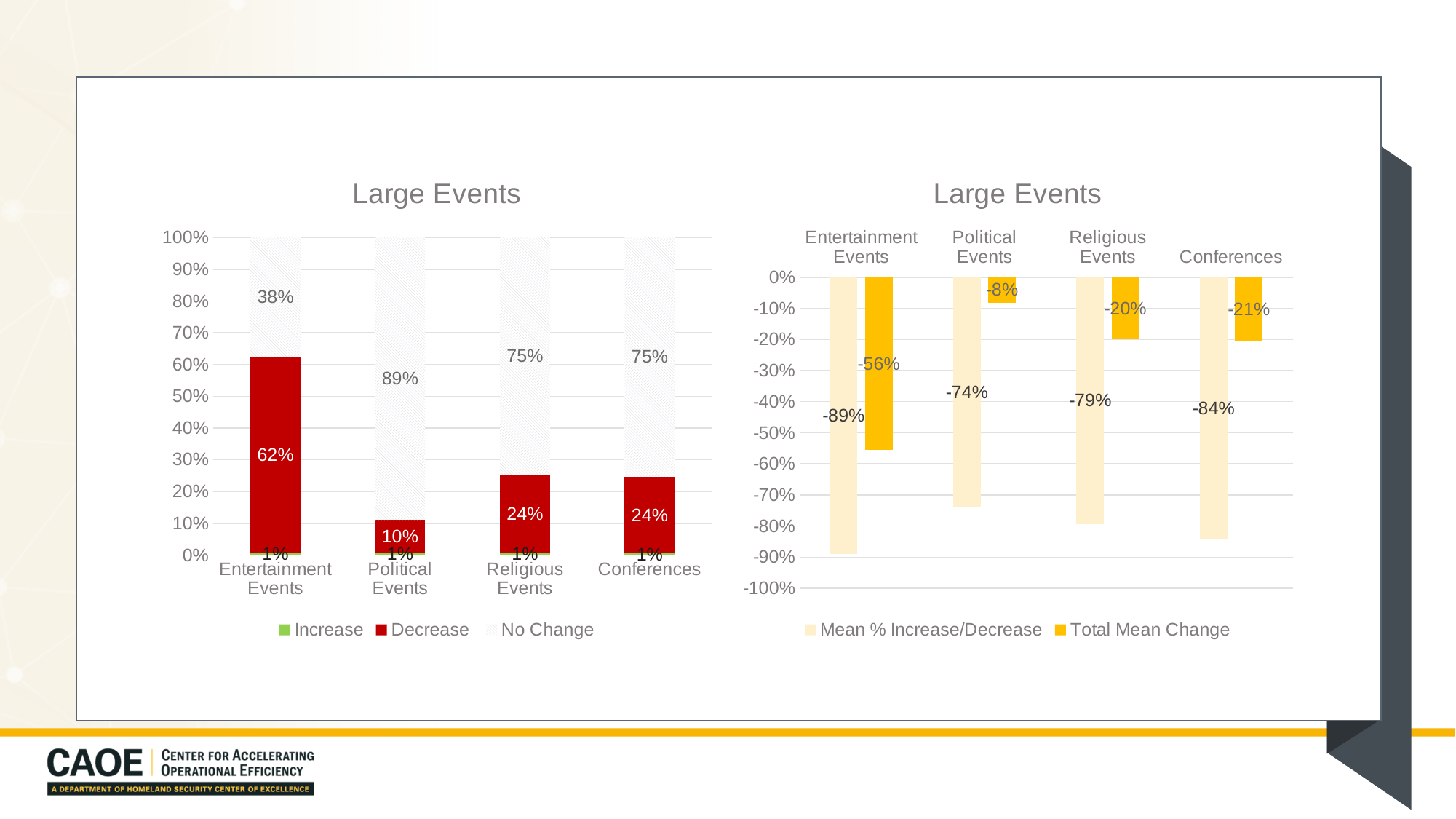
On the left chart, what is the No Change value for Political Events? 89% On the right chart, what is the Mean % Increase/Decrease for Conferences? -84% On the right chart, what is the difference between the Mean % Increase/Decrease for Entertainment Events and Political Events? 15% What kind of chart is the right chart? Bar chart On the left chart, which category has the highest Decrease value? Entertainment Events On the left chart, which category has the lowest No Change value? Entertainment Events On the right chart, which category has the lowest Mean % Increase/Decrease value? Entertainment Events On the right chart, what is the Total Mean Change for Political Events? -8% On the right chart, is the Total Mean Change for Entertainment Events or for Religious Events larger in magnitude? Entertainment Events On the left chart, how many series does the legend list? 3 On the left chart, what is the difference between the No Change values for Political Events and Entertainment Events? 51% On the left chart, what is the Decrease value for Entertainment Events? 62%